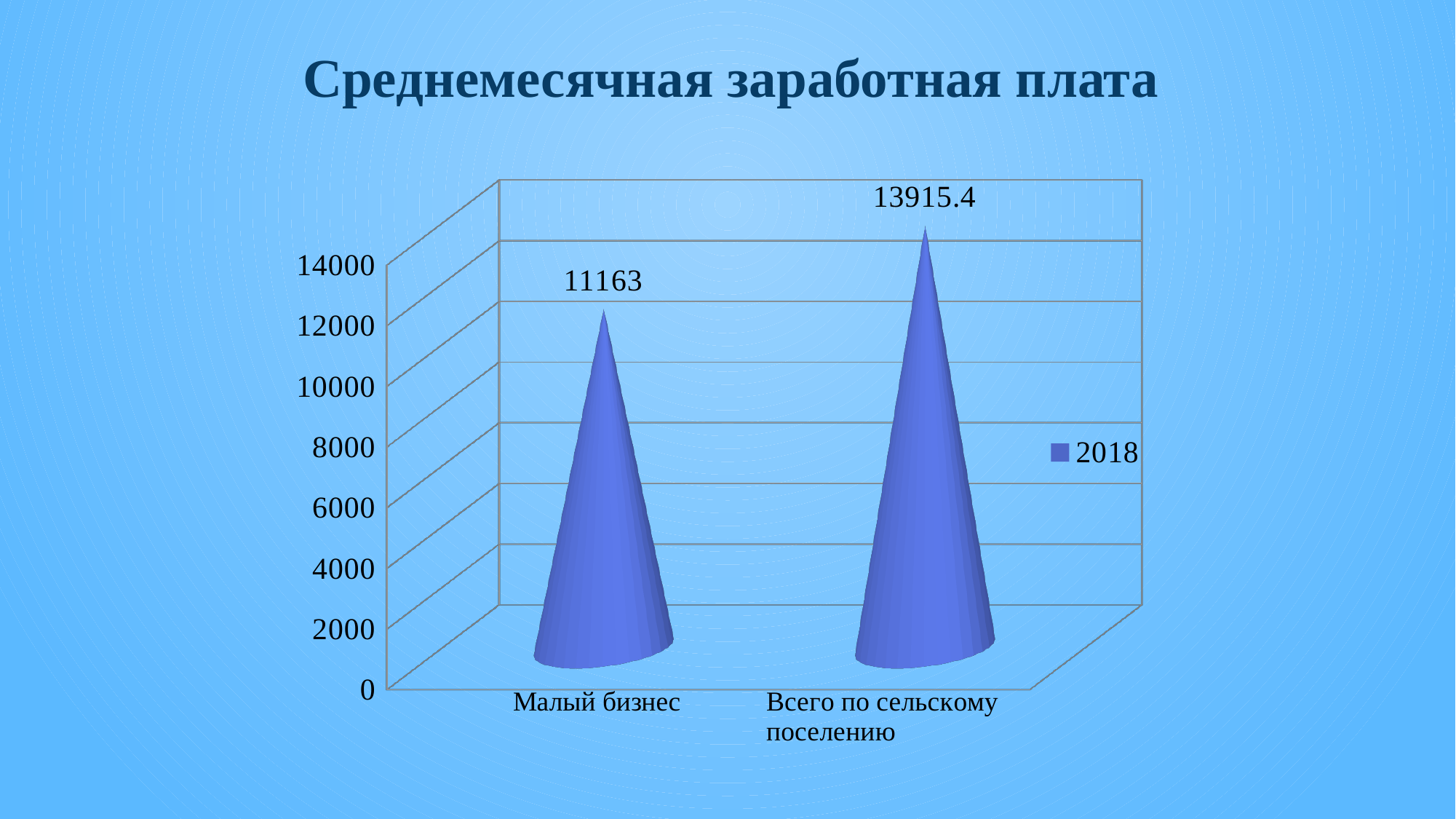
Which category has the highest value? Всего по сельскому поселению What is the value for Малый бизнес? 11163 What is the title of the chart? Среднемесячная заработная плата How many categories are shown on the x axis? 2 Which category has the lowest value? Малый бизнес What kind of chart is shown on the slide? bar chart What is the value for Всего по сельскому поселению? 13915.4 How many series does the legend list? 1 Is the value for Малый бизнес greater or less than 12000? less Which is larger: the value for Малый бизнес or the value for Всего по сельскому поселению? Всего по сельскому поселению What is the difference between the values for Всего по сельскому поселению and Малый бизнес? 2752.4 Is the value for Всего по сельскому поселению greater or less than 12000? greater